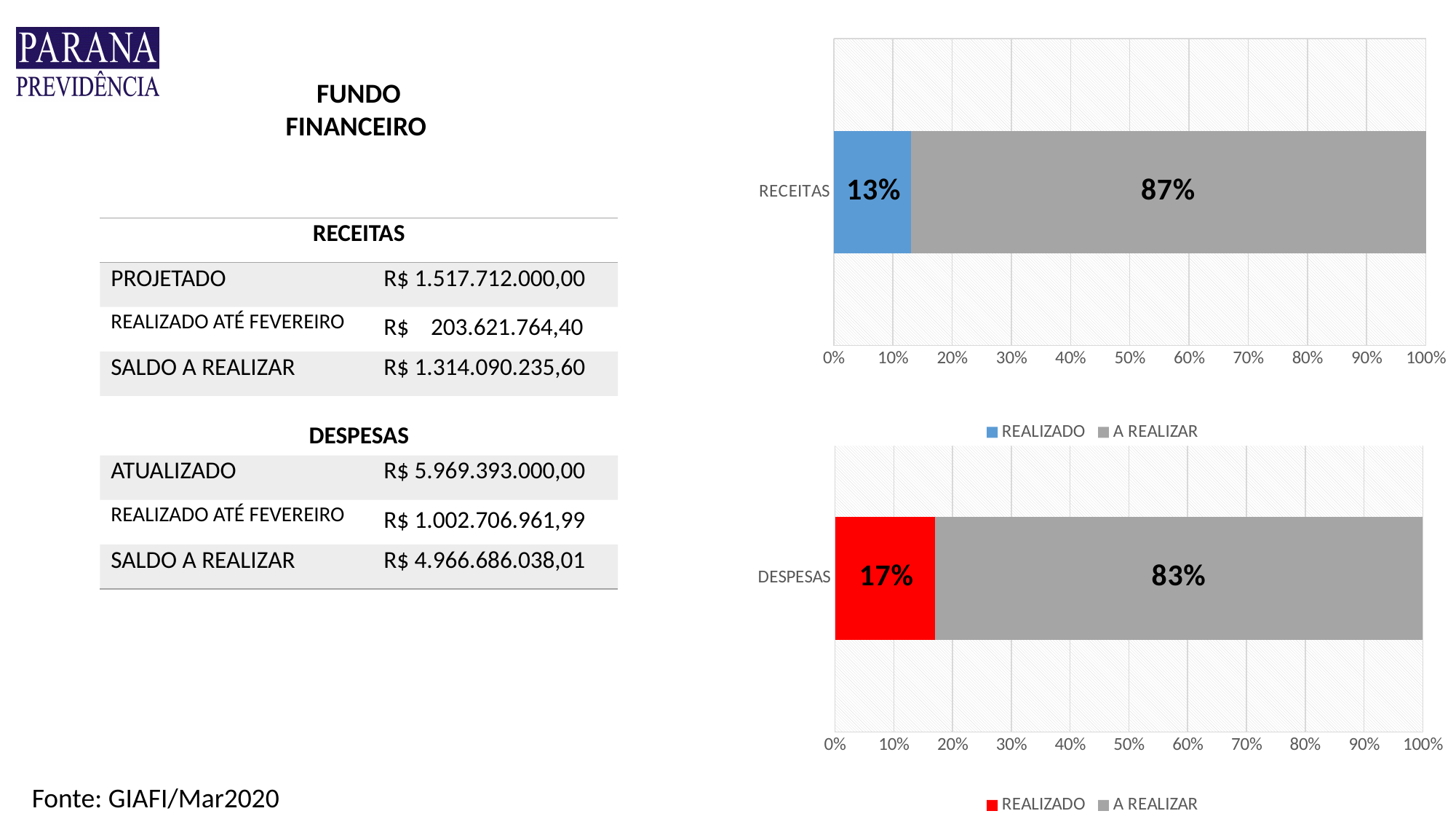
How many series does the legend of the top chart (RECEITAS) list? 2 In the bottom chart (DESPESAS), what colour is the REALIZADO series? Red In the top chart (RECEITAS), what colour is the REALIZADO series? Blue In the bottom chart (DESPESAS), what is the total of the stacked bar? 100% In the bottom chart (DESPESAS), what is the value for REALIZADO? 17% In the top chart (RECEITAS), what is the difference between A REALIZAR and REALIZADO? 74% In the top chart (RECEITAS), what is the value for REALIZADO? 13% In the bottom chart (DESPESAS), what is the value for A REALIZAR? 83% In the top chart (RECEITAS), what is the value for A REALIZAR? 87% What kind of chart is the bottom chart (DESPESAS)? Stacked bar chart In the bottom chart (DESPESAS), what is the difference between A REALIZAR and REALIZADO? 66% In the top chart (RECEITAS), which series has the larger value, REALIZADO or A REALIZAR? A REALIZAR